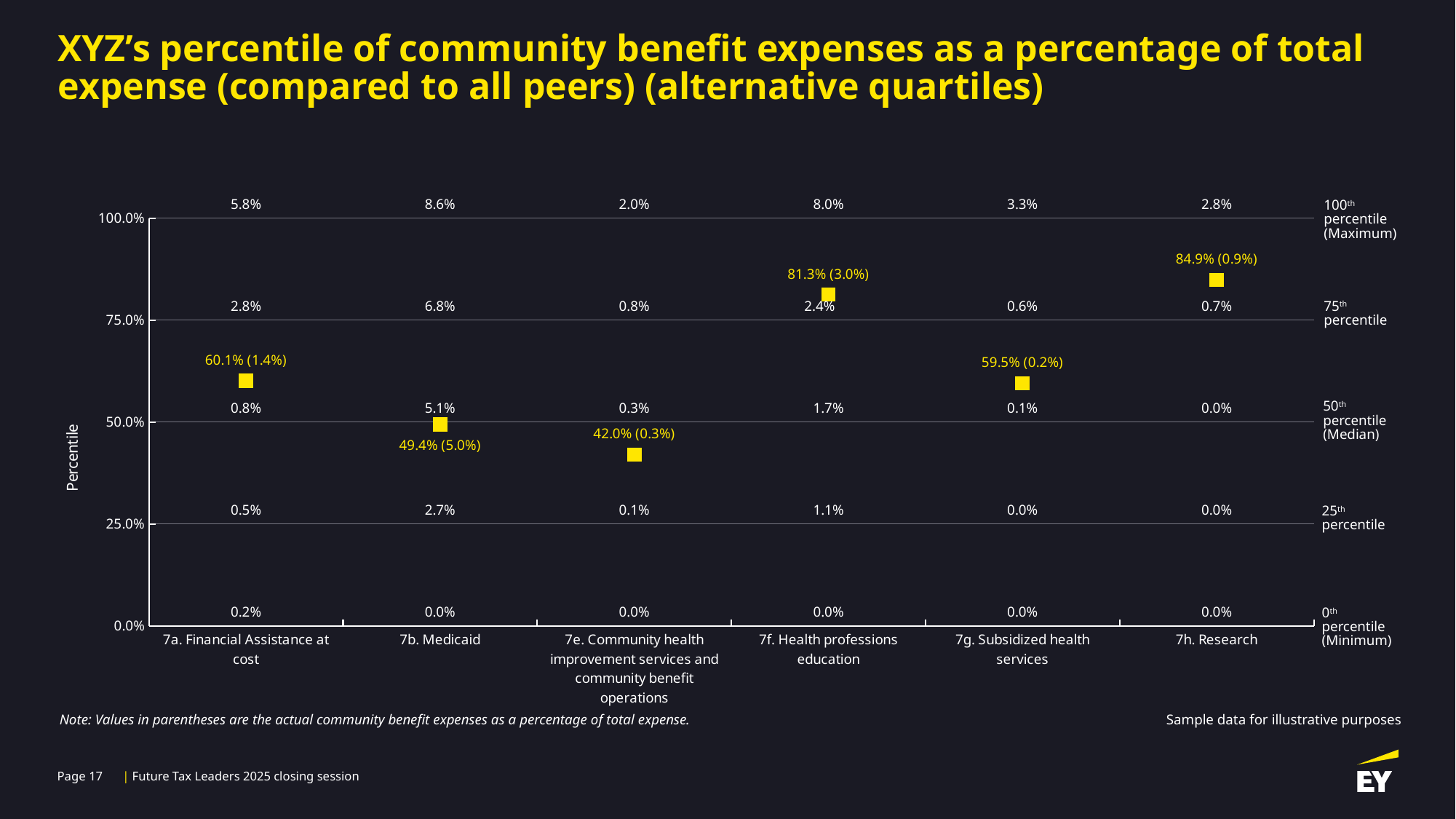
Which has the larger XYZ percentile: 7a. Financial Assistance at cost or 7g. Subsidized health services? 7a. Financial Assistance at cost How many categories are shown on the x axis? 6 What is the 75th percentile value shown for 7f. Health professions education? 2.4% What is XYZ's actual community benefit expense as a percentage of total expense for 7b. Medicaid (the value in parentheses)? 5.0% What is the 100th percentile (Maximum) value shown for 7b. Medicaid? 8.6% What is the label on the y axis? Percentile Which category has the lowest XYZ percentile? 7e. Community health improvement services and community benefit operations Is XYZ's percentile for 7b. Medicaid greater or less than 50.0%? less What is XYZ's percentile for 7h. Research? 84.9% What is the difference between XYZ's percentile for 7h. Research and for 7f. Health professions education? 3.6 percentage points Which category has the highest XYZ percentile? 7h. Research What is the 50th percentile (Median) value shown for 7a. Financial Assistance at cost? 0.8%